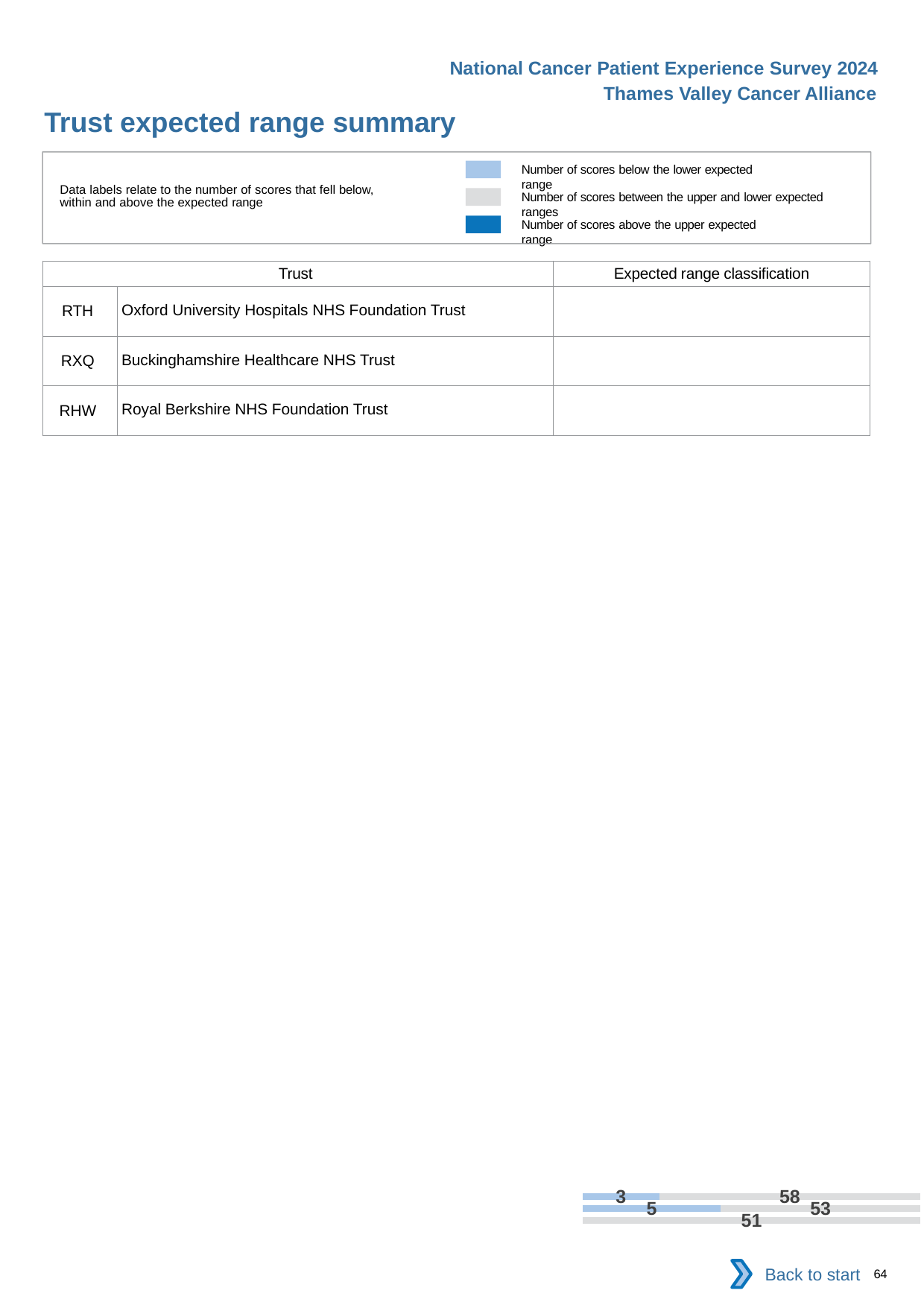
Which is larger: the grey value in the top bar (58) or the grey value in the middle bar (53)? 58 What value is labelled on the bottom bar at the bottom of the slide? 51 What is the total of the middle stacked bar (5 and 53)? 58 In the top bar at the bottom of the slide, what is the grey (within expected range) value? 58 In the middle bar at the bottom of the slide, what is the light blue (below the lower expected range) value? 5 How many stacked bars are shown at the bottom of the slide? 3 What kind of chart is shown at the bottom of the slide? bar chart In the top bar at the bottom of the slide, what is the light blue (below the lower expected range) value? 3 What is the total of the top stacked bar (3 and 58)? 61 In the middle bar at the bottom of the slide, what is the grey (within expected range) value? 53 How many series does the legend at the top of the slide list? 3 What is the difference between the grey value in the top bar (58) and the grey value in the middle bar (53)? 5